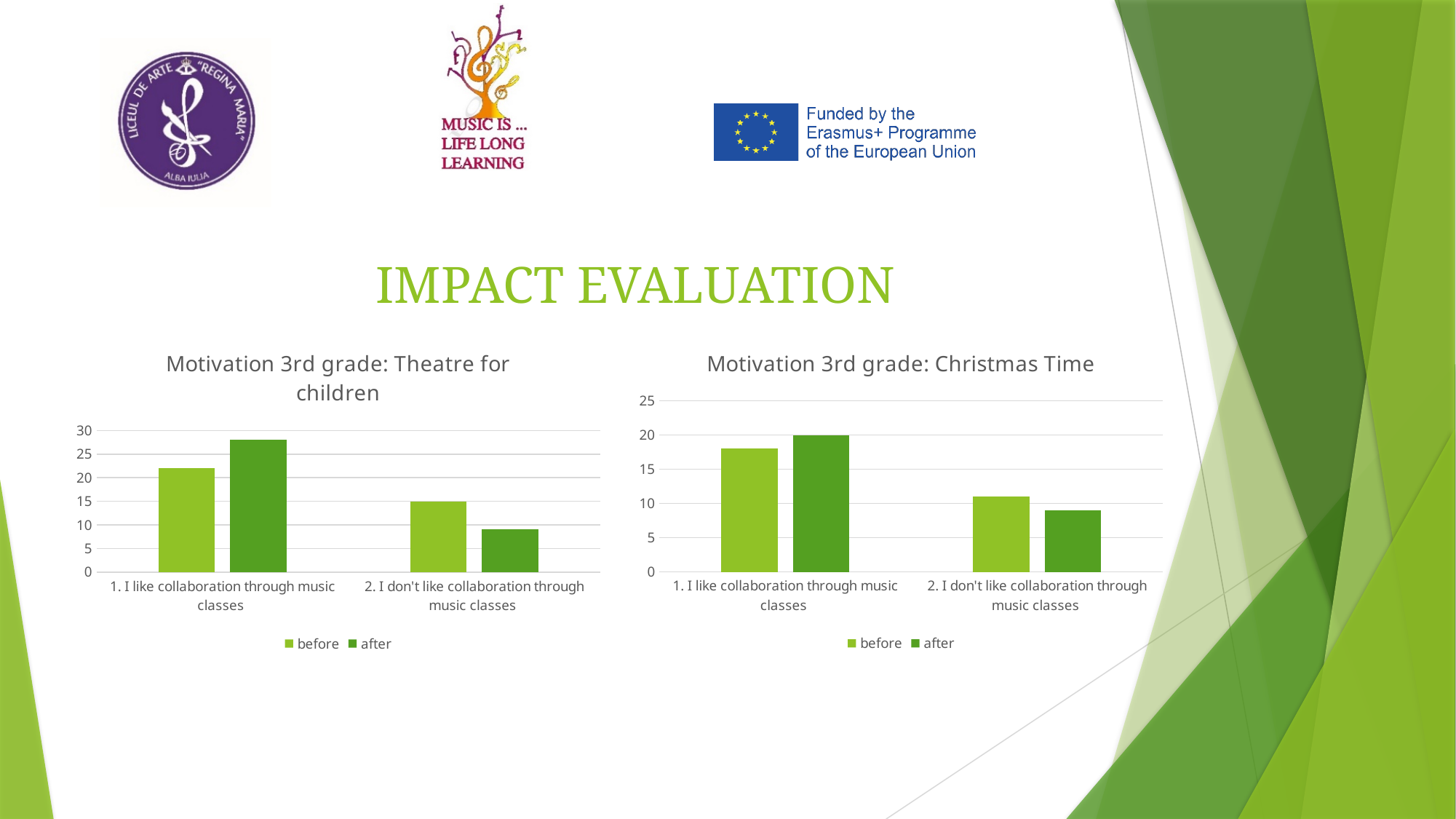
In the 'Motivation 3rd grade: Christmas Time' chart, which bar is the tallest? after, 1. I like collaboration through music classes In the 'Motivation 3rd grade: Theatre for children' chart, is the 'after' value for '2. I don't like collaboration through music classes' greater or less than 10? less In the 'Motivation 3rd grade: Theatre for children' chart, which series is shown in the darker green colour? after In the 'Motivation 3rd grade: Theatre for children' chart, what is the 'before' value for '2. I don't like collaboration through music classes'? 15 In the 'Motivation 3rd grade: Christmas Time' chart, what is the 'after' value for '1. I like collaboration through music classes'? 20 In the 'Motivation 3rd grade: Theatre for children' chart, which is larger for '1. I like collaboration through music classes': the 'before' or the 'after' value? after In the 'Motivation 3rd grade: Theatre for children' chart, is the 'after' value for '1. I like collaboration through music classes' greater or less than 25? greater In the 'Motivation 3rd grade: Theatre for children' chart, what kind of chart is shown? bar chart In the 'Motivation 3rd grade: Christmas Time' chart, is the 'before' value for '1. I like collaboration through music classes' greater or less than 15? greater In the 'Motivation 3rd grade: Christmas Time' chart, how many series does the legend list? 2 In the 'Motivation 3rd grade: Theatre for children' chart, how many categories are shown on the x axis? 2